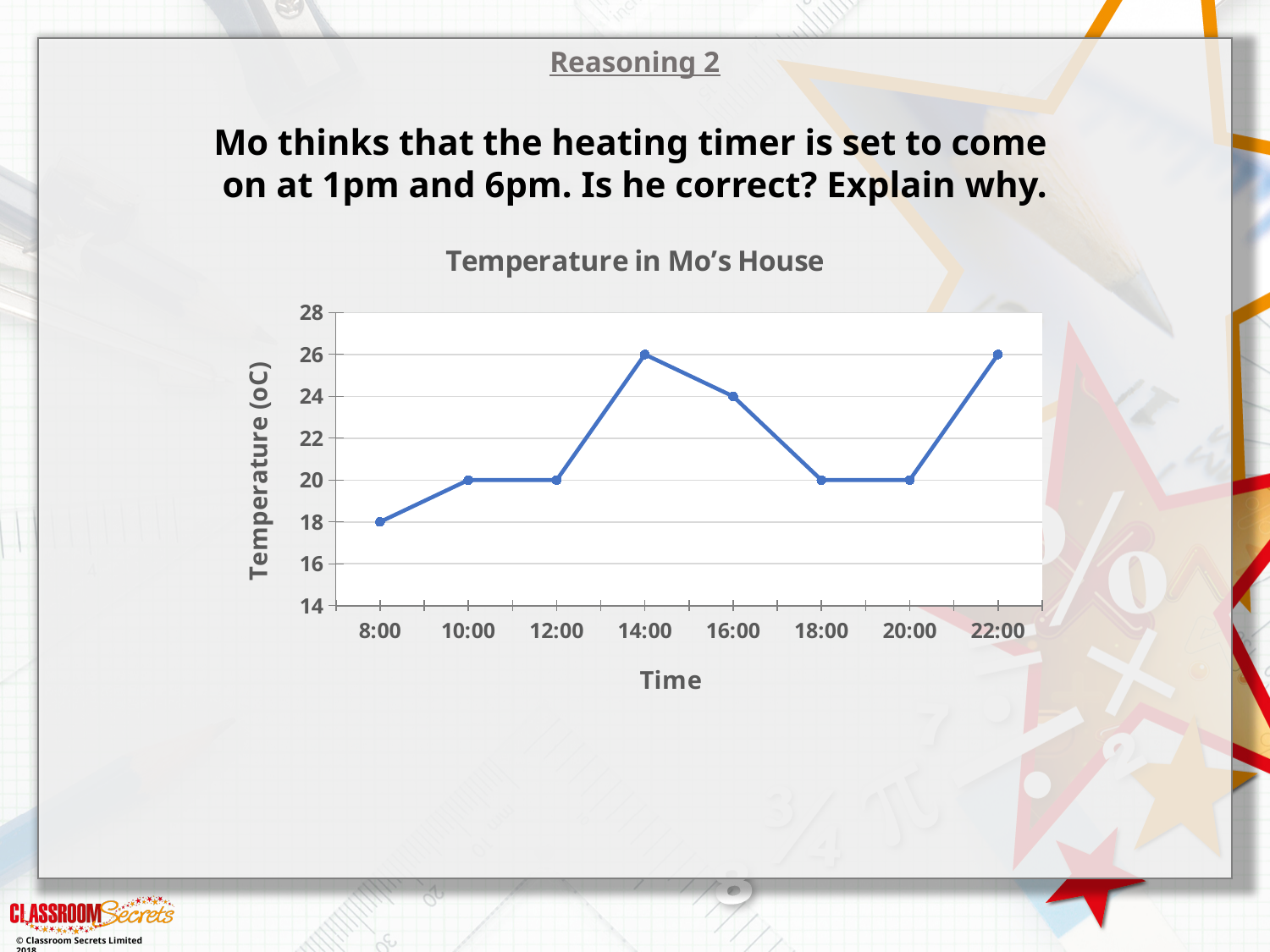
What is the temperature at 16:00? 24 Which is higher, the temperature at 16:00 or the temperature at 20:00? 16:00 What type of chart is shown on the slide? line chart What is the temperature at 18:00? 20 What is the difference between the temperature at 14:00 and the temperature at 12:00? 6 How many time points are plotted on the chart? 8 What is the label on the vertical axis? Temperature (oC) Does the temperature rise or fall between 14:00 and 18:00? fall What is the temperature at 8:00? 18 What is the temperature at 14:00? 26 What is the title of the chart? Temperature in Mo's House At which time is the temperature lowest? 8:00